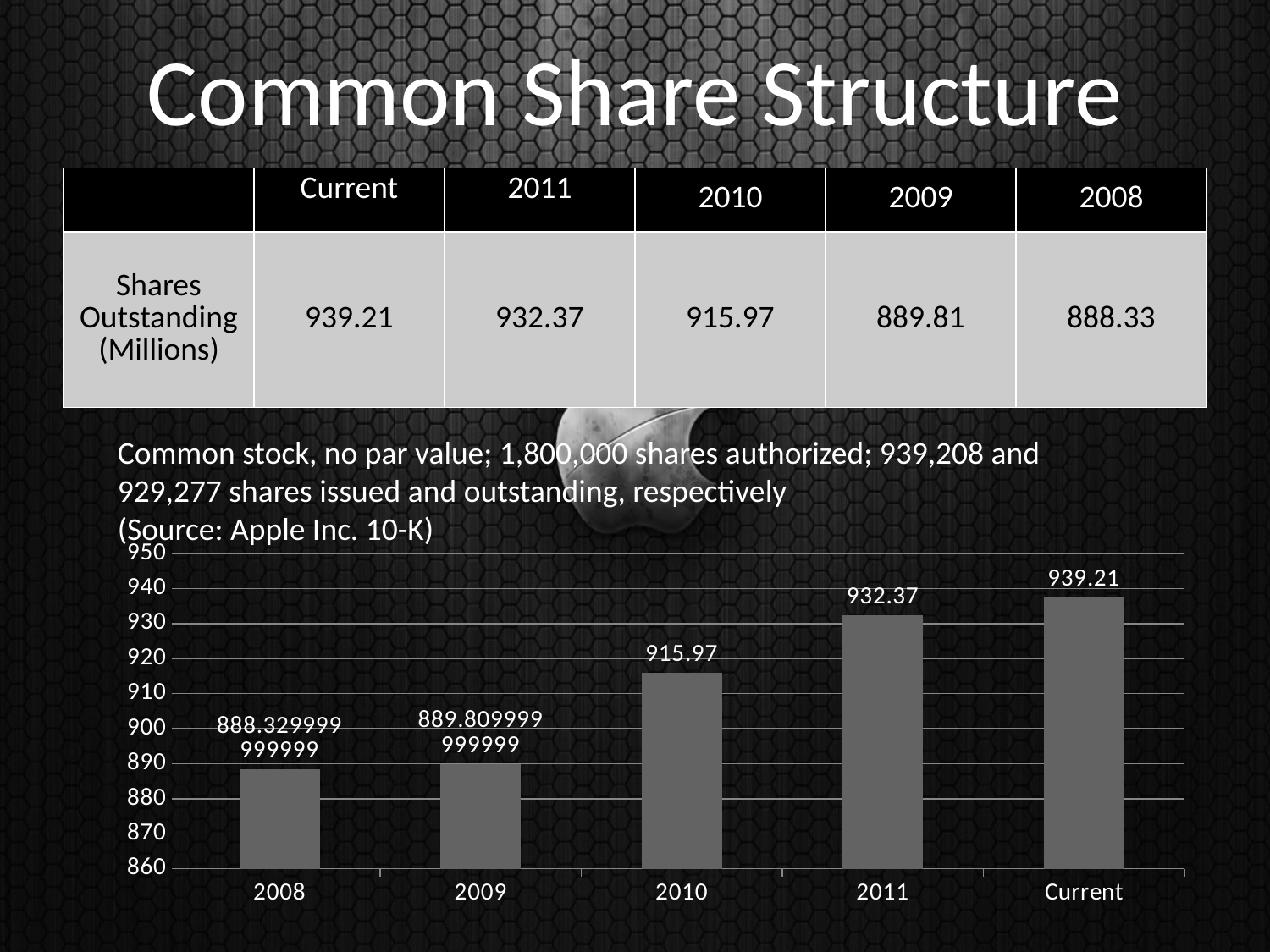
What is the value shown for 2010 in the chart? 915.97 What type of chart is shown on the slide? bar chart Is the value for 2009 greater or less than 900? less Which category has the highest bar in the chart? Current What is the difference between the Current value and the 2011 value? 6.84 What is the value shown for Current in the chart? 939.21 Do the values rise or fall from 2008 to Current along the x axis? rise Which is larger, the value for 2010 or the value for 2011? 2011 What is the value shown for 2011 in the chart? 932.37 How many bars are plotted in the chart? 5 Is the value for 2008 greater or less than 890? less What is the difference between the 2011 value and the 2010 value? 16.40